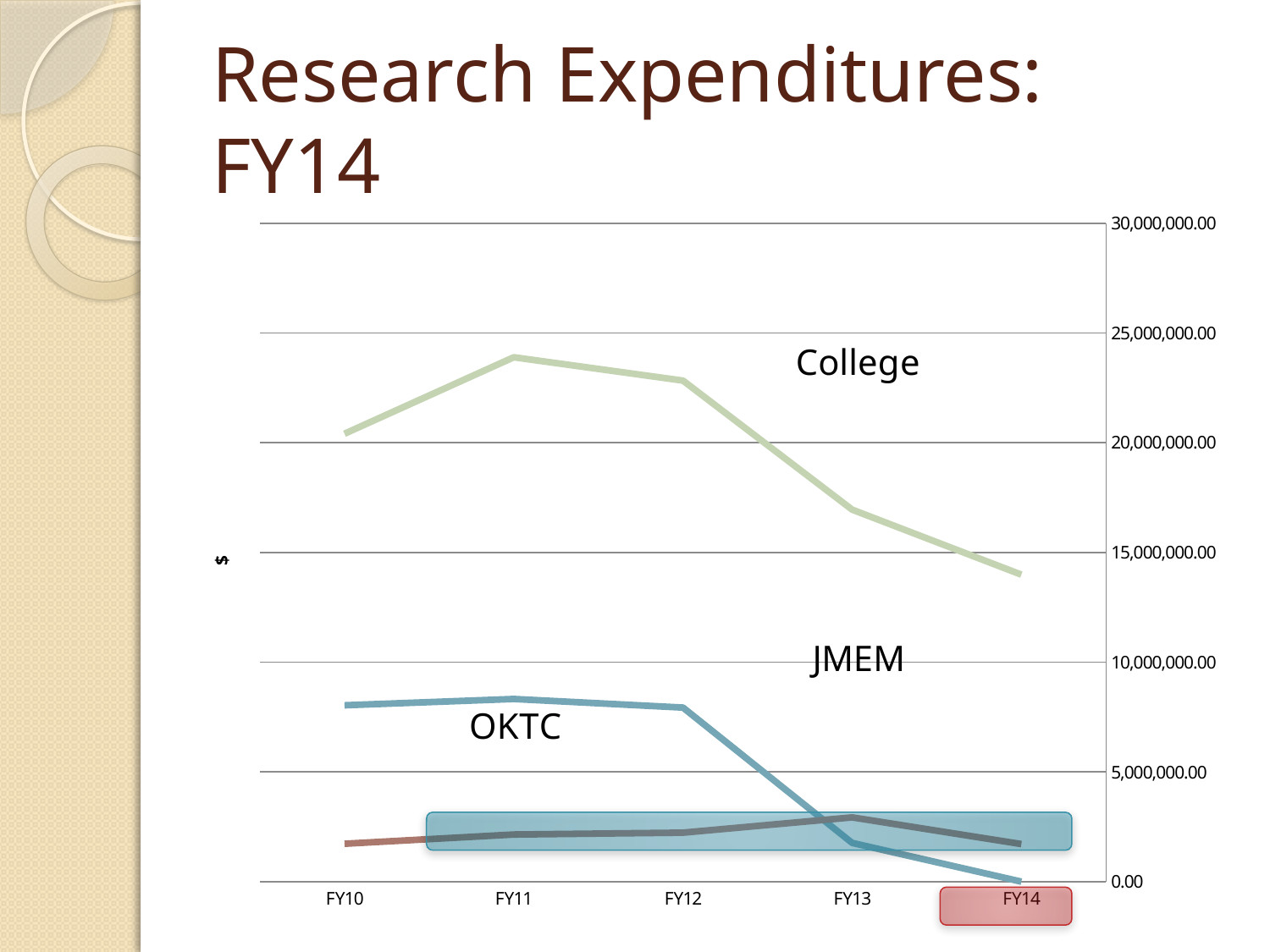
What is the title of the slide containing the chart? Research Expenditures: FY14 Is the OKTC value for FY14 greater or less than 5,000,000.00? less In which fiscal year does the JMEM series reach its highest value? FY11 Does the College series rise or fall from FY11 to FY14? fall How many fiscal years are shown on the x axis? 5 What kind of chart is shown on the slide? line chart Which series has the larger value in FY14, OKTC or JMEM? OKTC In which fiscal year does the College series reach its highest value? FY11 Is the College value for FY11 greater or less than 20,000,000.00? greater How many data series are labelled on the chart? 3 In which fiscal year is the College series at its lowest value? FY14